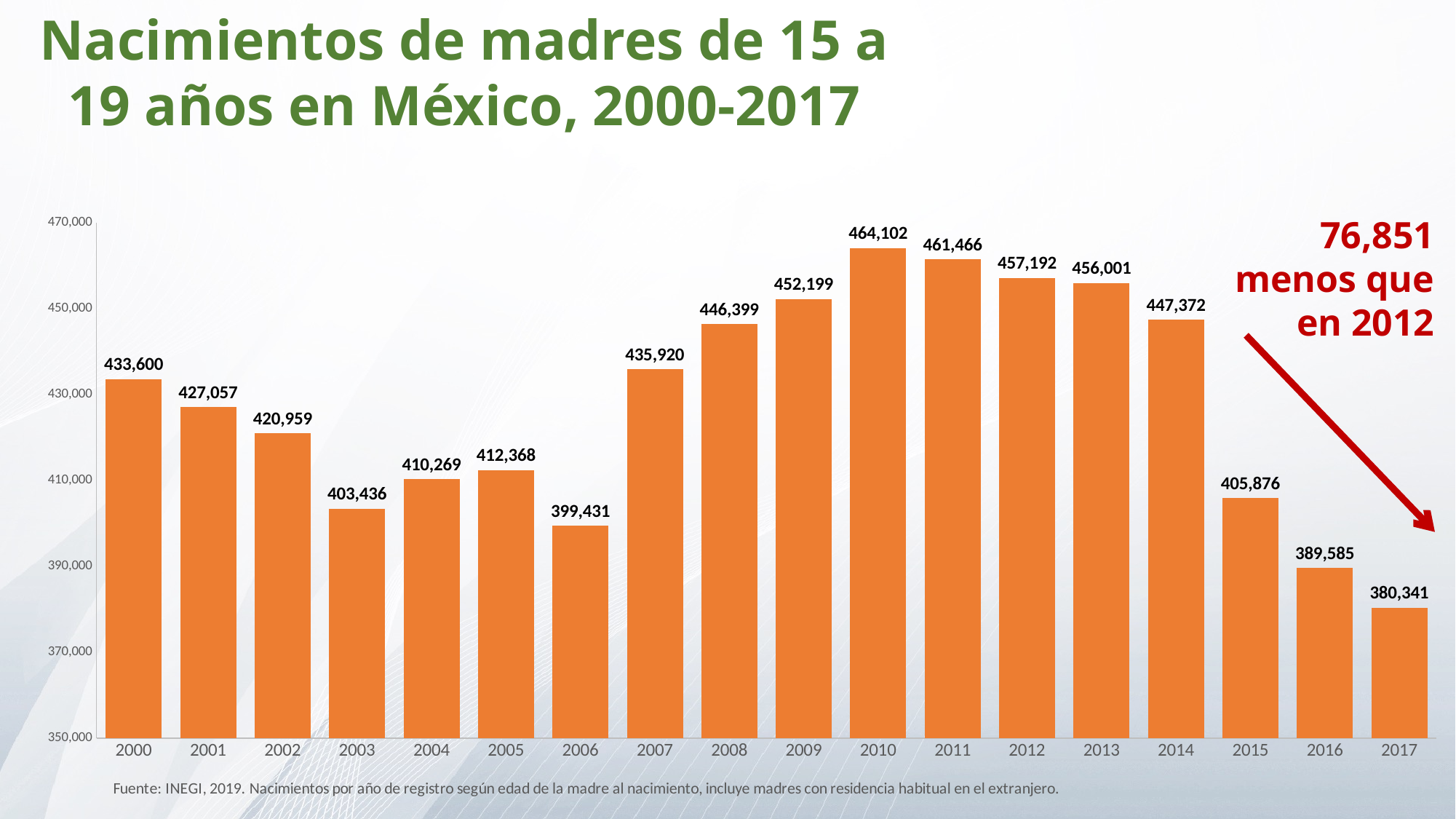
Which is larger, the value for 2003 or the value for 2004? 2004 What kind of chart is shown on the slide? bar chart Which year has the highest value? 2010 How many years are shown on the x axis? 18 Do the values rise or fall from 2010 to 2017? fall What is the value for 2010? 464,102 What is the value for 2017? 380,341 What is the value for 2006? 399,431 Which year has the lowest value? 2017 Is the value for 2008 greater or less than 450,000? less What is the difference between the values for 2012 and 2017? 76,851 What is the difference between the values for 2000 and 2001? 6,543